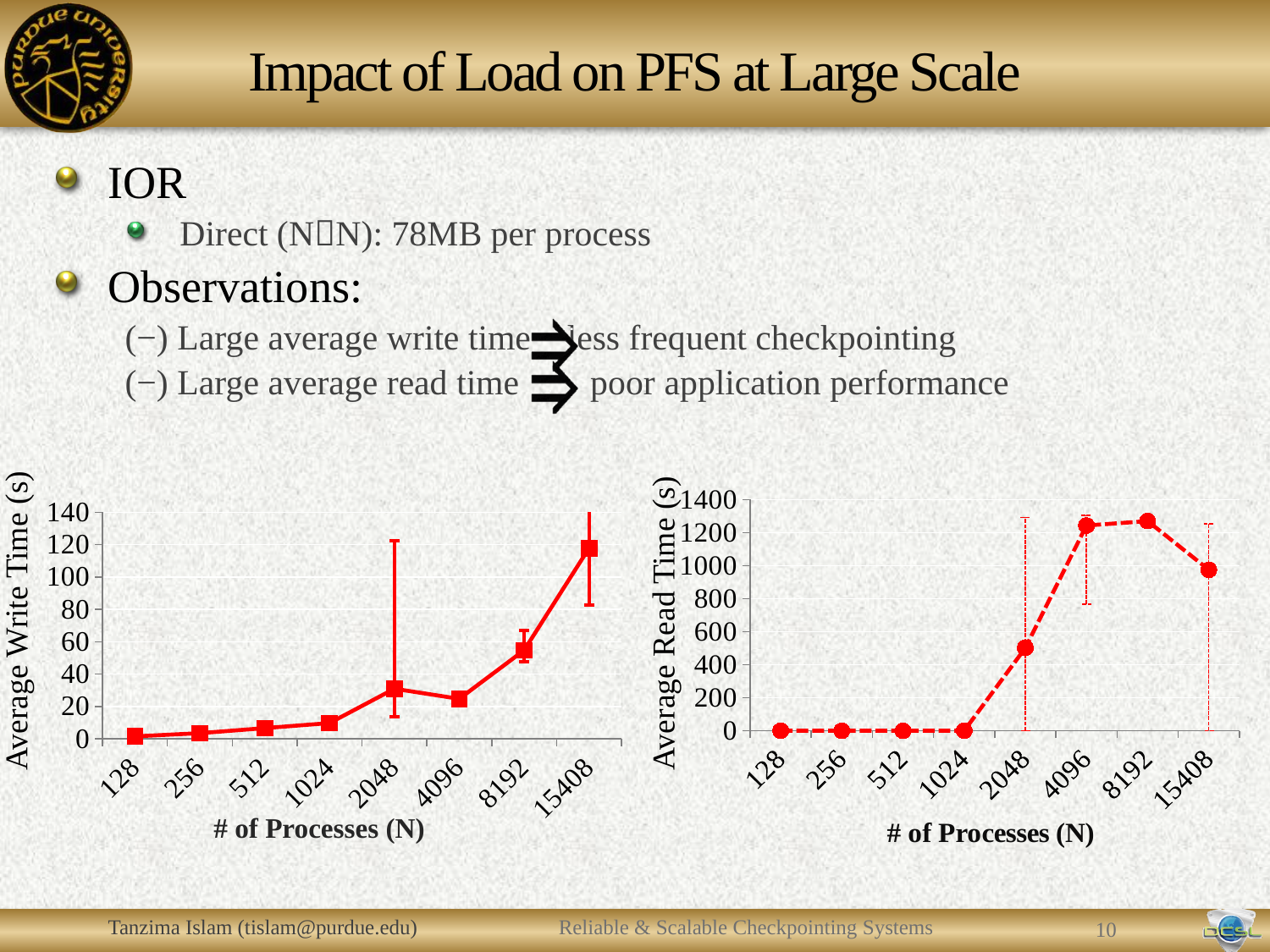
In the left chart (Average Write Time), is the value for 4096 processes greater or less than 40? less In the right chart (Average Read Time), is the value for 15408 processes greater or less than 1200? less In the right chart (Average Read Time), which has the larger average read time, 1024 processes or 4096 processes? 4096 In the right chart (Average Read Time), is the value for 2048 processes greater or less than 400? greater What kind of chart is the left chart (Average Write Time)? line chart In the left chart (Average Write Time), which number of processes has the highest average write time? 15408 In the left chart (Average Write Time), which has the larger average write time, 2048 processes or 8192 processes? 8192 What is the y-axis label of the left chart? Average Write Time (s) How many process counts are plotted on the x axis of the left chart (Average Write Time)? 8 What is the x-axis label of the right chart (Average Read Time)? # of Processes (N)